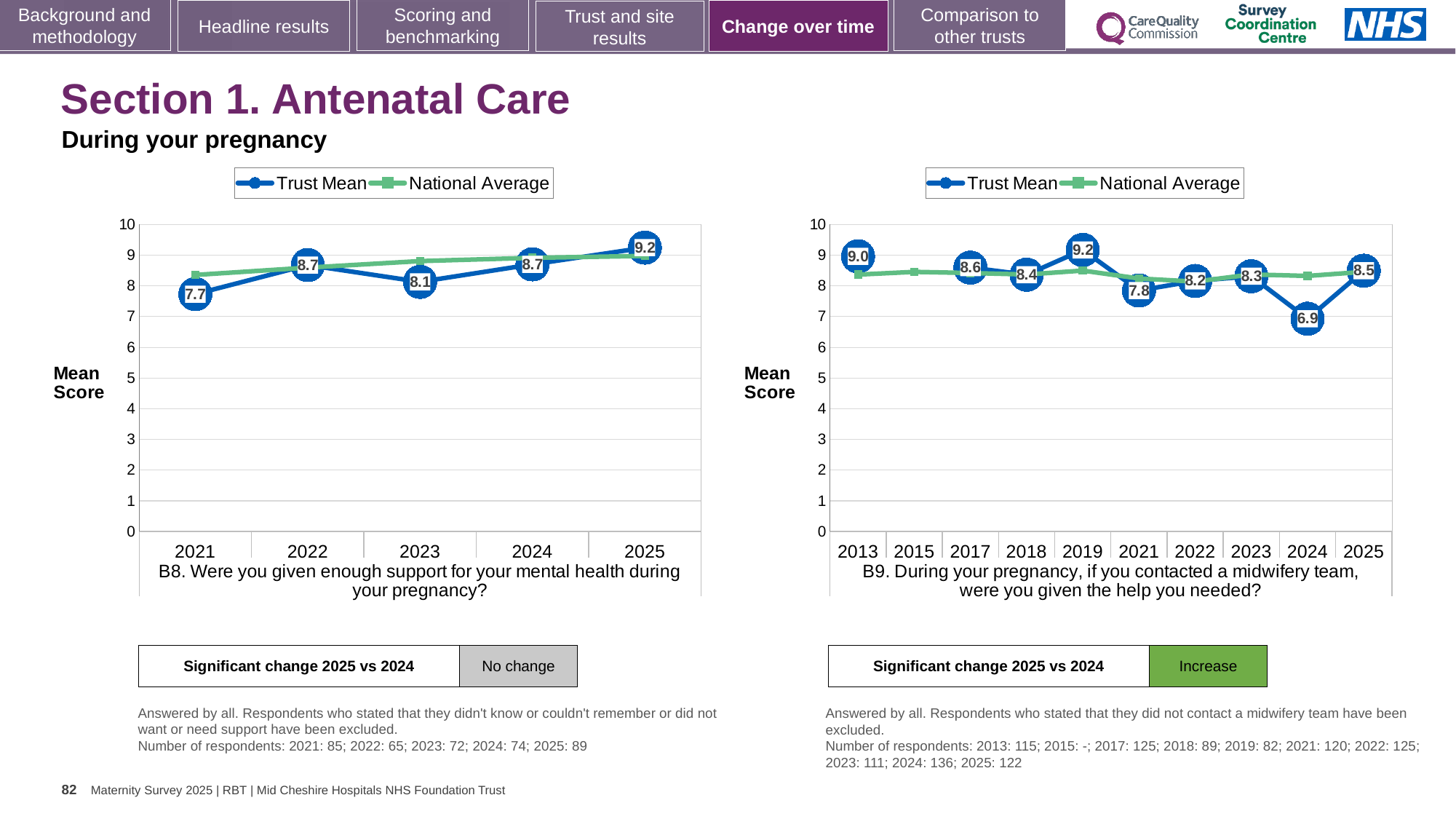
In the B8 chart on the left, what is the Trust Mean for 2025? 9.2 In the B9 chart on the right, what is the Trust Mean for 2019? 9.2 In the B9 chart on the right, is the Trust Mean for 2013 larger or smaller than the Trust Mean for 2025? larger In the B9 chart on the right, which year has the lowest Trust Mean? 2024 What kind of chart is the B8 chart on the left? line chart In the B8 chart on the left, how many series does the legend list? 2 In the B8 chart on the left, which year has the lowest Trust Mean? 2021 In the B9 chart on the right, what is the Trust Mean for 2024? 6.9 In the B9 chart on the right, how many years are shown on the x axis? 10 In the B9 chart on the right, which year has the highest Trust Mean? 2019 In the B8 chart on the left, what is the difference between the Trust Mean for 2025 and for 2023? 1.1 In the B8 chart on the left, what is the Trust Mean for 2021? 7.7